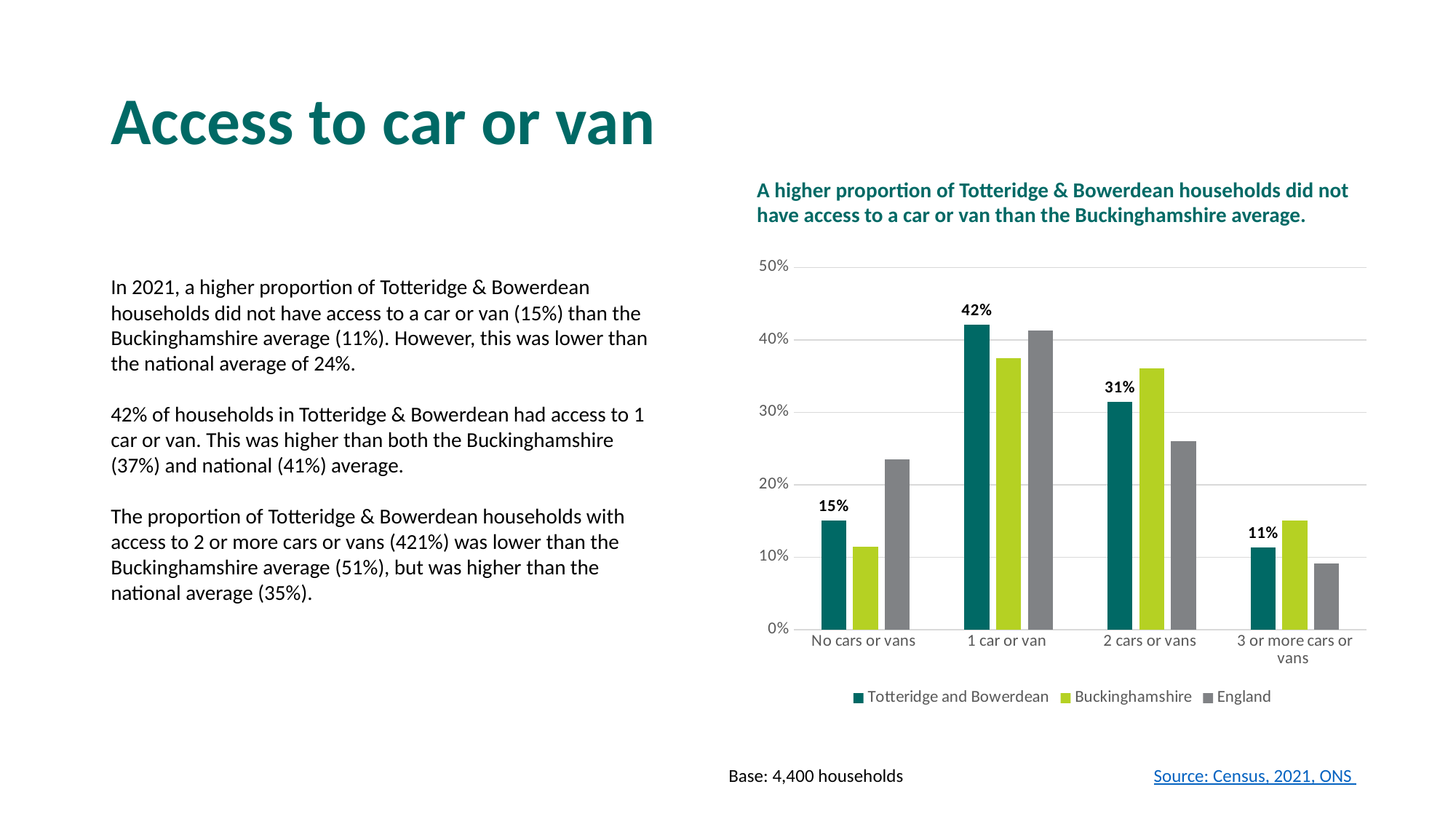
How many categories are shown on the x axis? 4 For no cars or vans, which is larger: the Totteridge and Bowerdean value or the England value? England Which category has the lowest value for Totteridge and Bowerdean? 3 or more cars or vans Is the Buckinghamshire value for 2 cars or vans greater or less than 30%? greater What kind of chart is shown on the slide? Bar chart Is the England value for 3 or more cars or vans greater or less than 10%? less Which category has the highest value for Totteridge and Bowerdean? 1 car or van What percentage of Totteridge and Bowerdean households had 1 car or van? 42% What percentage of Totteridge and Bowerdean households had 3 or more cars or vans? 11% How many series does the legend list? 3 What percentage of Totteridge and Bowerdean households had no cars or vans? 15% What is the difference between the Totteridge and Bowerdean values for 1 car or van and 2 cars or vans? 11%